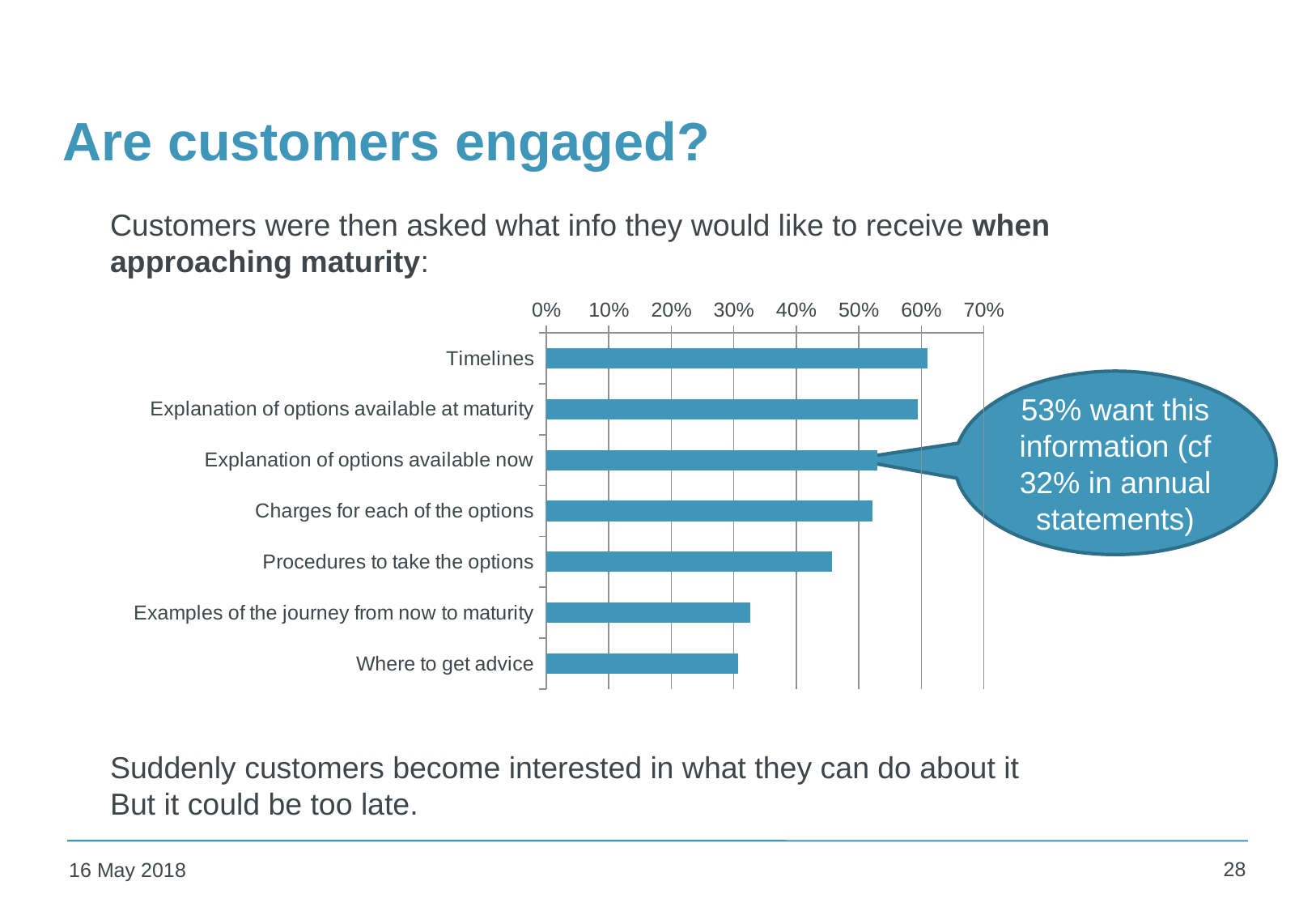
How many categories does the bar chart show? 7 What kind of chart is shown on the slide? bar chart Is the value for Charges for each of the options greater or less than 40%? greater Is the value for Procedures to take the options greater or less than 40%? greater According to the callout, what percentage of customers want an explanation of options available now? 53% According to the callout, what percentage wanted this information in annual statements? 32% Is the value for Examples of the journey from now to maturity greater or less than 40%? less Which is larger, the value for Timelines or the value for Where to get advice? Timelines Which is larger, the value for Procedures to take the options or the value for Examples of the journey from now to maturity? Procedures to take the options What is the highest value shown on the percentage axis of the chart? 70%